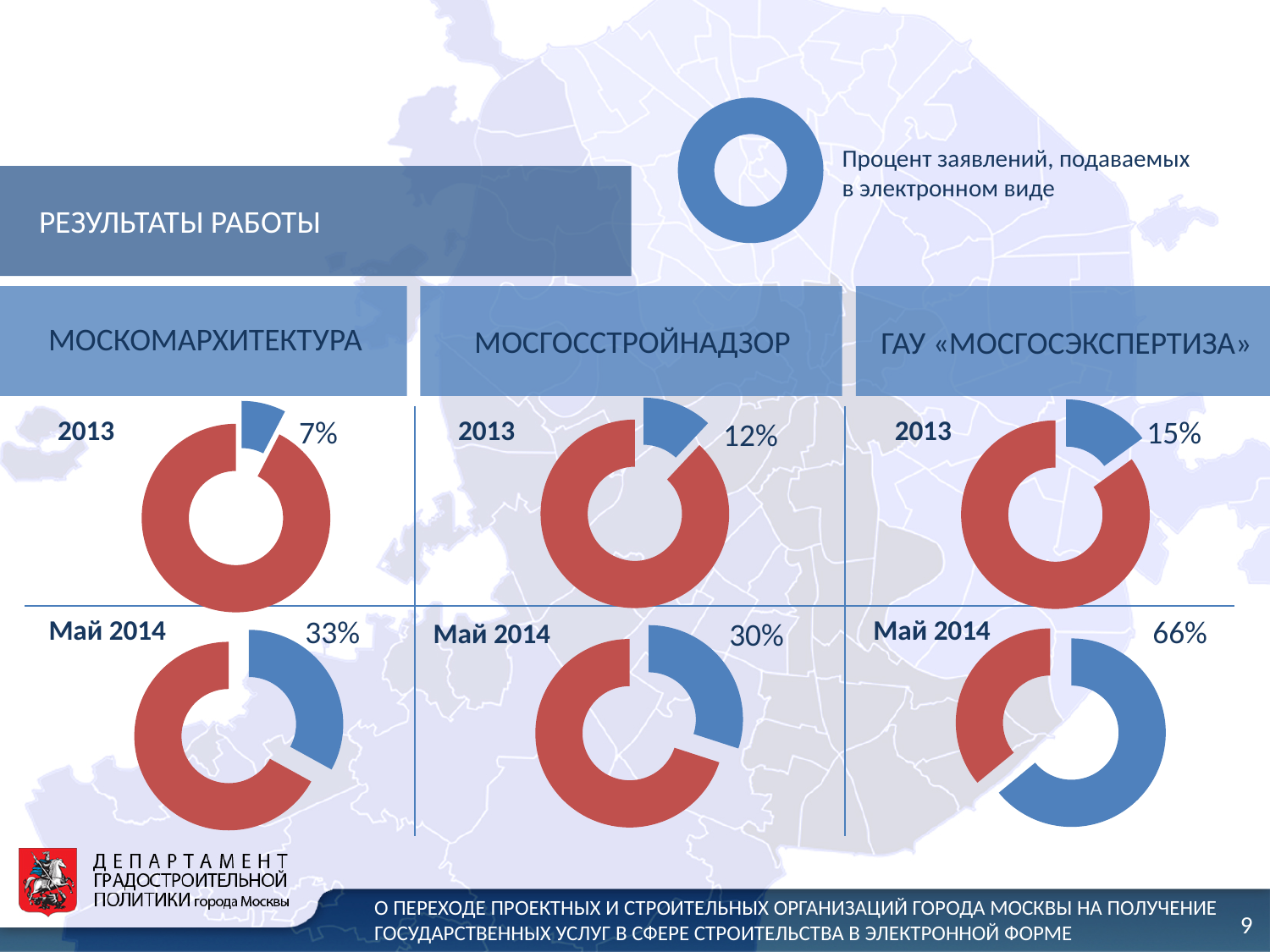
What percentage is shown for Мосгосстройнадзор in 2013? 12% By how many percentage points did the share for ГАУ «Мосгосэкспертиза» increase from 2013 to Май 2014? 51 What percentage is shown for ГАУ «Мосгосэкспертиза» in 2013? 15% How many donut charts are shown on the slide? 6 What percentage is shown for ГАУ «Мосгосэкспертиза» in Май 2014? 66% Which is larger: the Май 2014 value for Москомархитектура or for Мосгосстройнадзор? Москомархитектура What percentage is shown for Мосгосстройнадзор in Май 2014? 30% Which organization has the lowest share of electronic applications in 2013? Москомархитектура Which organization has the highest share of electronic applications in Май 2014? ГАУ «Мосгосэкспертиза» What percentage of applications were submitted electronically for Москомархитектура in 2013? 7% What type of chart is used to show the percentages on this slide? Donut (pie) chart What percentage is shown for Москомархитектура in Май 2014? 33%